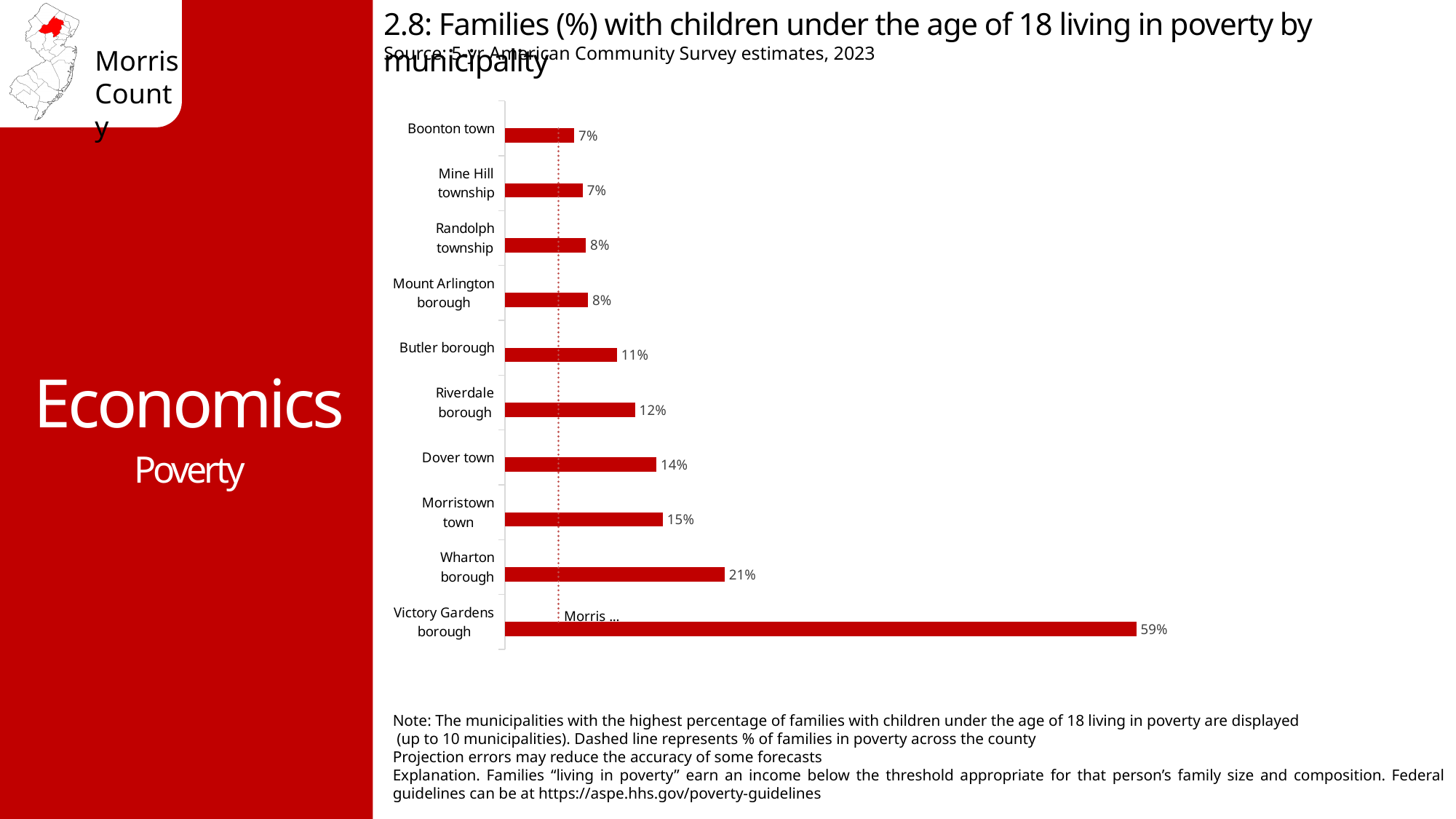
What does the dashed vertical line on the chart represent? % of families in poverty across the county What percentage of families with children under 18 are living in poverty in Victory Gardens borough? 59% What type of chart is used on this slide? Bar chart What is the difference in percentage points between Morristown town and Riverdale borough? 3 percentage points What is the value shown for Wharton borough? 21% What is the difference in percentage points between Victory Gardens borough and Wharton borough? 38 percentage points What percentage is shown for Dover town? 14% What percentage is shown for Butler borough? 11% How many municipalities are shown in the chart? 10 Which municipality has the highest percentage of families with children under 18 living in poverty? Victory Gardens borough What is the value for Morristown town? 15% Which has a higher value, Dover town or Butler borough? Dover town